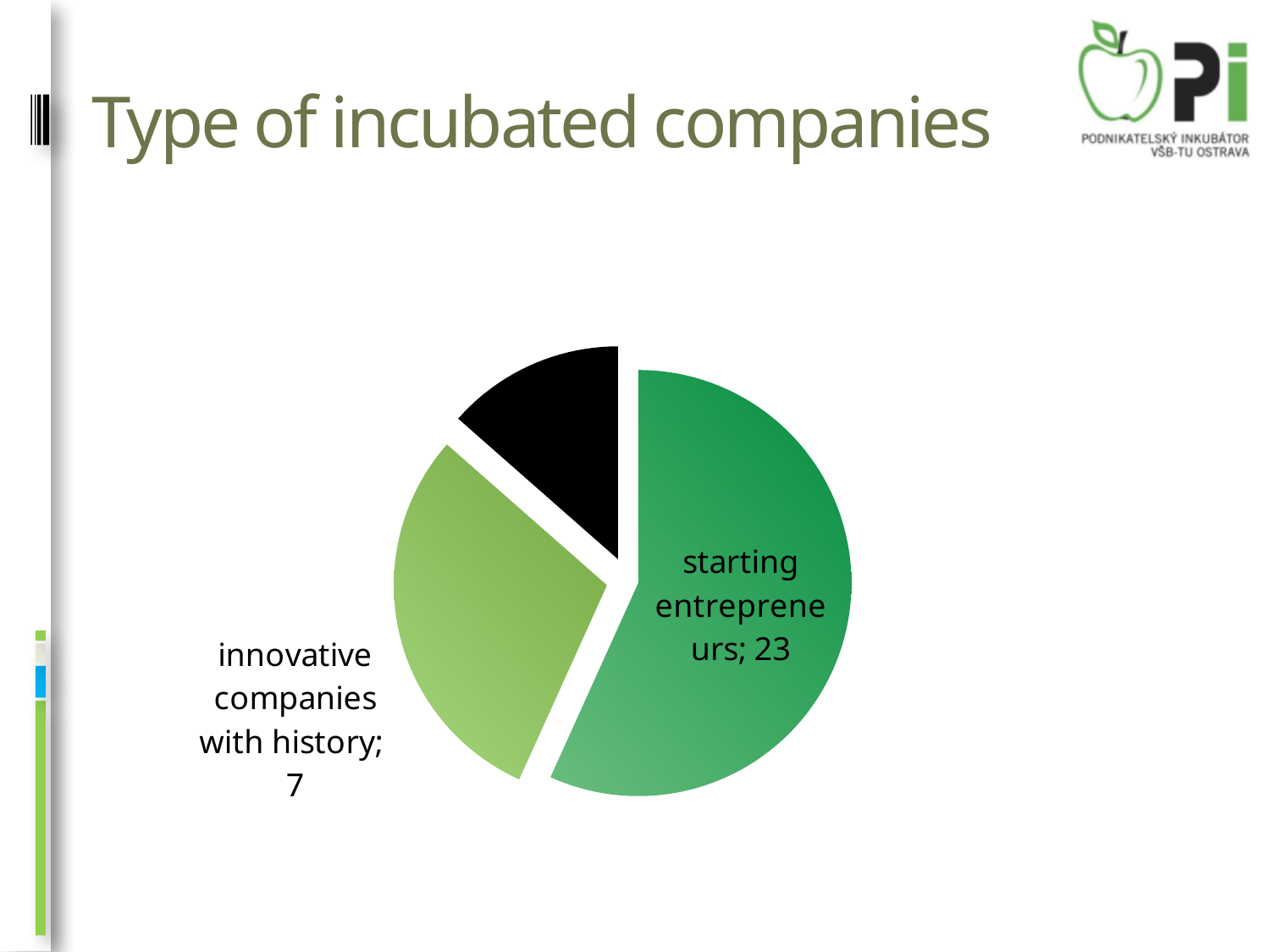
What kind of chart is shown on the slide? pie chart What colour is the slice for starting entrepreneurs? green What value is shown for innovative companies with history? 7 Which is larger: starting entrepreneurs or innovative companies with history? starting entrepreneurs What is the title of the slide containing the chart? Type of incubated companies What is the difference between the value for starting entrepreneurs and the value for innovative companies with history? 16 How many slices does the pie chart have? 3 Which labelled category has the largest slice in the pie chart? starting entrepreneurs How many starting entrepreneurs are shown in the pie chart? 23